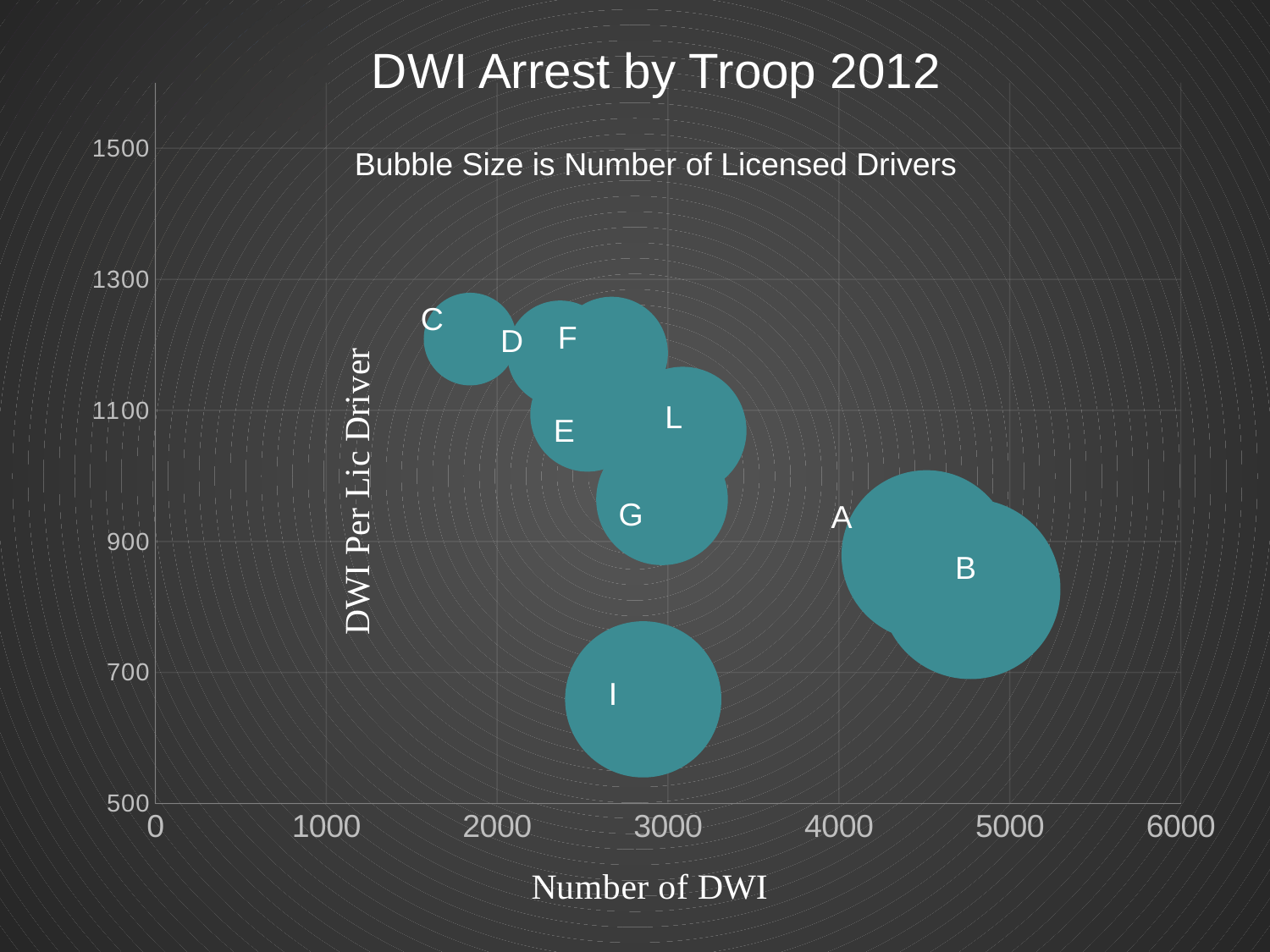
Which troop has a larger Number of DWI, A or C? A According to the subtitle, what does the bubble size represent? Number of Licensed Drivers What kind of chart is shown on the slide? Bubble chart What is the title of the chart? DWI Arrest by Troop 2012 Is the Number of DWI for troop C greater or less than 3000? less Is the DWI Per Lic Driver value for troop I greater or less than 900? less Which troop has the lowest Number of DWI? C Is the DWI Per Lic Driver value for troop F greater or less than 1100? greater Which troop has the highest Number of DWI? B Which troop has the lowest DWI Per Lic Driver value? I How many troop bubbles are plotted on the chart? 9